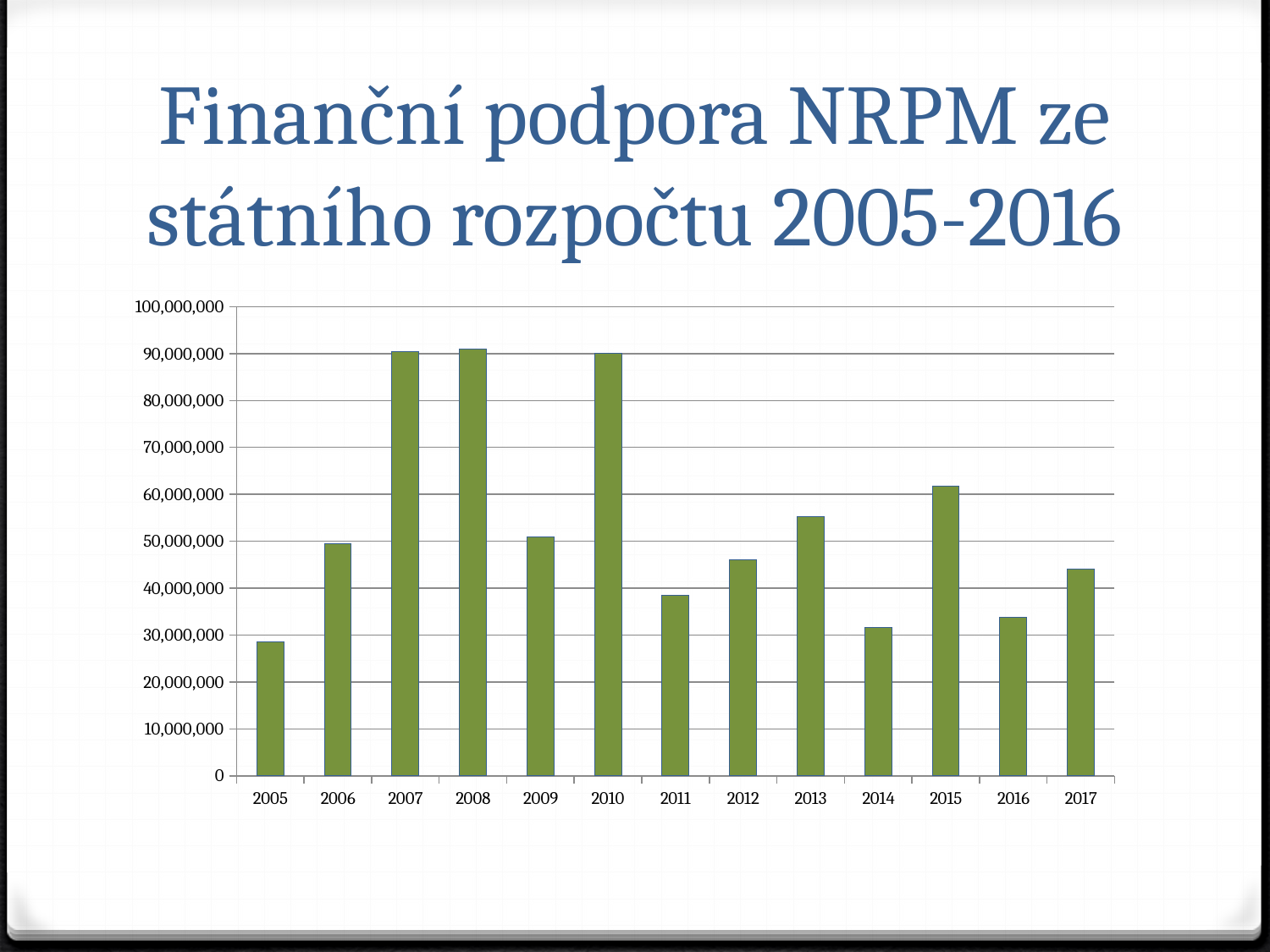
Is the value for 2005 greater or less than 30,000,000? less Is the value for 2013 greater or less than 50,000,000? greater Does the value rise or fall from 2014 to 2015? rise Which year has the larger value, 2006 or 2011? 2006 Is the value for 2007 greater or less than 80,000,000? greater How many years are shown on the x axis of the chart? 13 Does the value rise or fall from 2010 to 2011? fall Which year has the larger value, 2015 or 2013? 2015 What kind of chart is shown on the slide? bar chart What is the title of the slide containing the chart? Finanční podpora NRPM ze státního rozpočtu 2005-2016